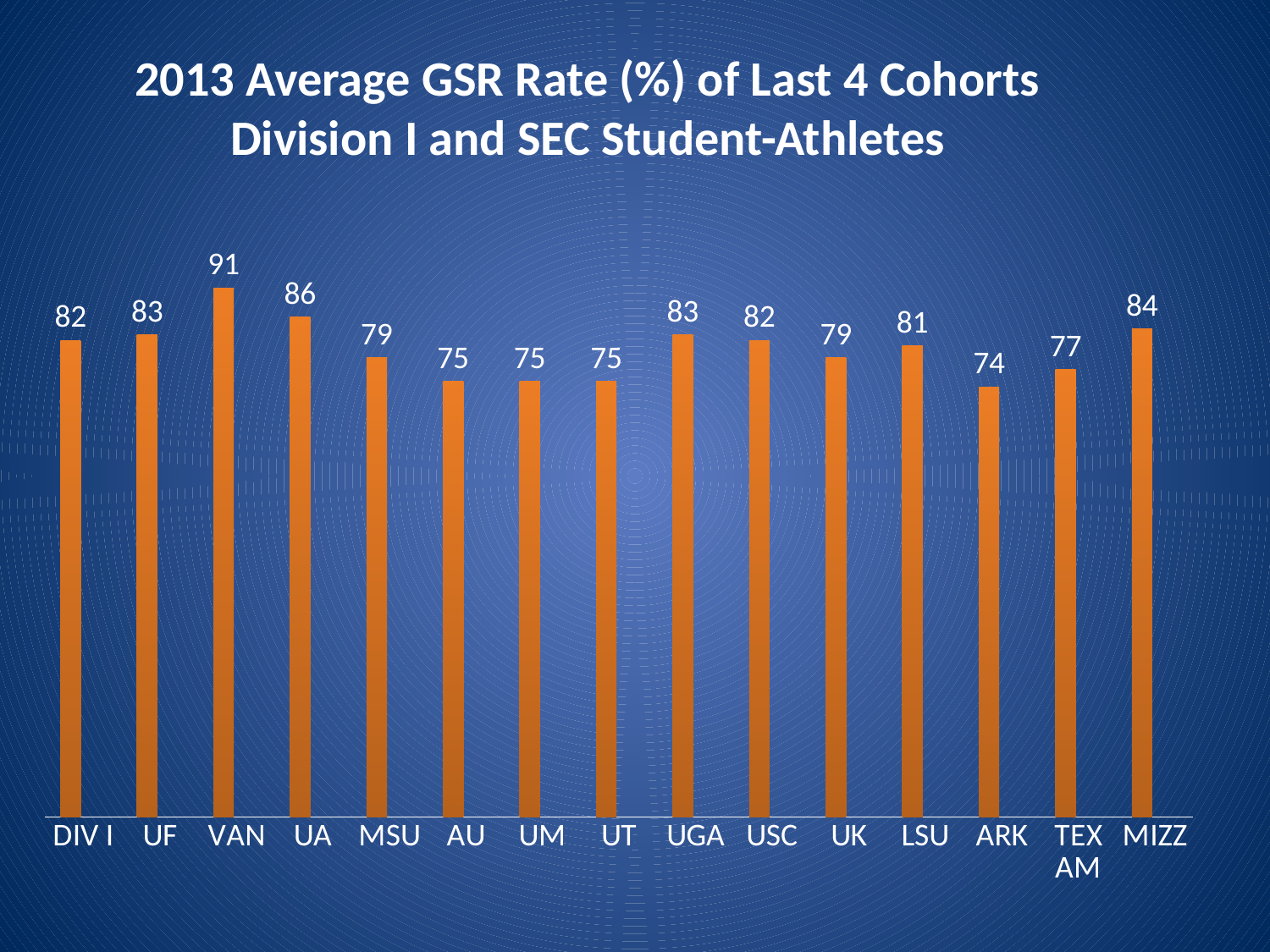
What is the title of the chart? 2013 Average GSR Rate (%) of Last 4 Cohorts Division I and SEC Student-Athletes What kind of chart is this? bar chart What is the value for ARK? 74 Which category has the highest value? VAN Which category has the lowest value? ARK How many categories are shown on the x axis? 15 What is the difference between the values for UA and UGA? 3 Which is larger, the value for LSU or the value for TEX AM? LSU What is the value for MIZZ? 84 What is the value for DIV I? 82 What is the difference between the values for VAN and ARK? 17 What is the value for VAN? 91